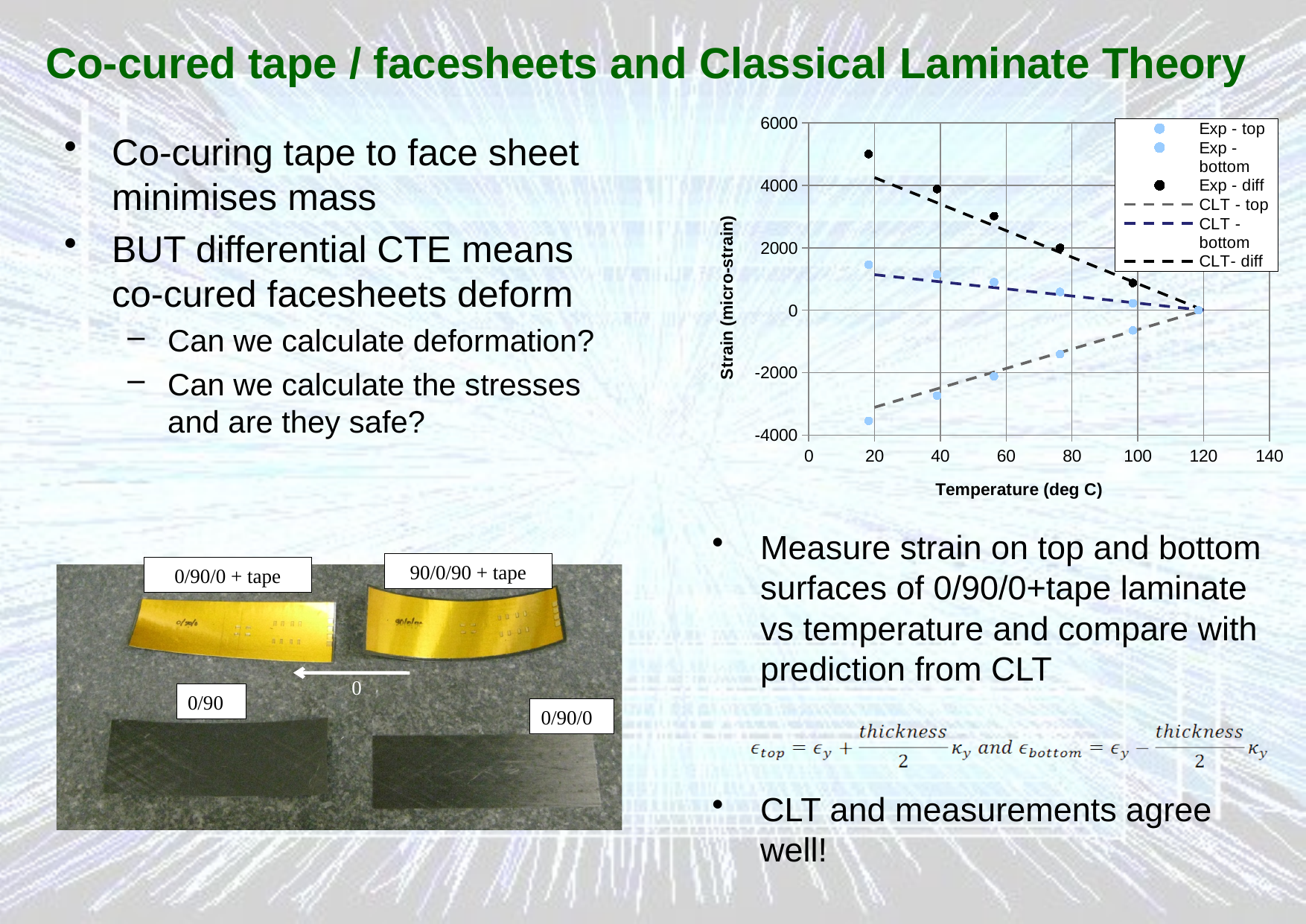
Which series has the highest strain value at about 20 deg C? Exp - diff Does the Exp - bottom strain rise or fall as temperature increases? fall What is the label of the x axis of the chart? Temperature (deg C) Is the Exp - diff value at about 20 deg C greater or less than 4000? greater At about 40 deg C, which is larger: the Exp - diff value or the Exp - bottom value? Exp - diff How many series does the chart legend list? 6 What kind of chart is shown on the slide? scatter chart Is the Exp - top value at about 20 deg C greater or less than -2000? less Does the Exp - diff strain rise or fall as temperature increases? fall Does the Exp - top strain rise or fall as temperature increases? rise What is the label of the y axis of the chart? Strain (micro-strain) Is the Exp - diff value at about 100 deg C greater or less than 2000? less